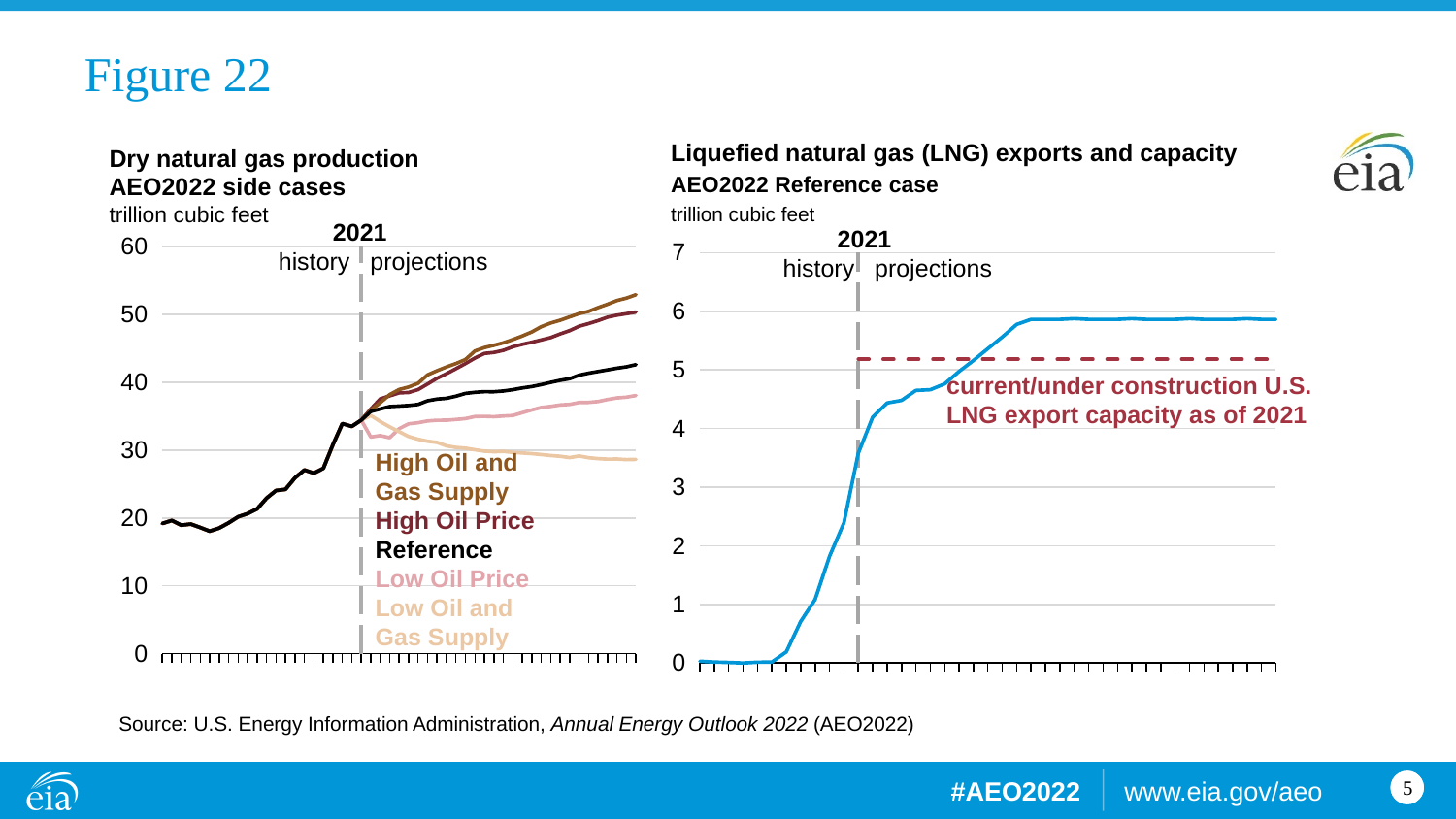
In the 'Dry natural gas production' chart, how many side cases are labeled? 5 What kind of chart is the 'Dry natural gas production' chart on the left? line chart What kind of chart is the 'Liquefied natural gas (LNG) exports and capacity' chart on the right? line chart In the 'Dry natural gas production' chart, which case has the lowest production at the end of the projection period? Low Oil and Gas Supply In the 'Liquefied natural gas (LNG) exports and capacity' chart, what does the dashed horizontal line represent? current/under construction U.S. LNG export capacity as of 2021 In the 'Dry natural gas production' chart, is the Low Oil and Gas Supply value at the end of the projections greater or less than 30? less In the 'Dry natural gas production' chart, is the High Oil and Gas Supply value at the end of the projections greater or less than 50? greater In the 'Dry natural gas production' chart, which case has the highest production at the end of the projection period? High Oil and Gas Supply In the 'Dry natural gas production' chart, at the end of the projections, which is larger: the High Oil Price case or the Reference case? High Oil Price What unit is used on the y axis of both charts? trillion cubic feet In the 'Liquefied natural gas (LNG) exports and capacity' chart, do LNG exports rise or fall over the history period leading up to 2021? rise In the 'Liquefied natural gas (LNG) exports and capacity' chart, is the LNG export value at the end of the projections greater or less than 6? less